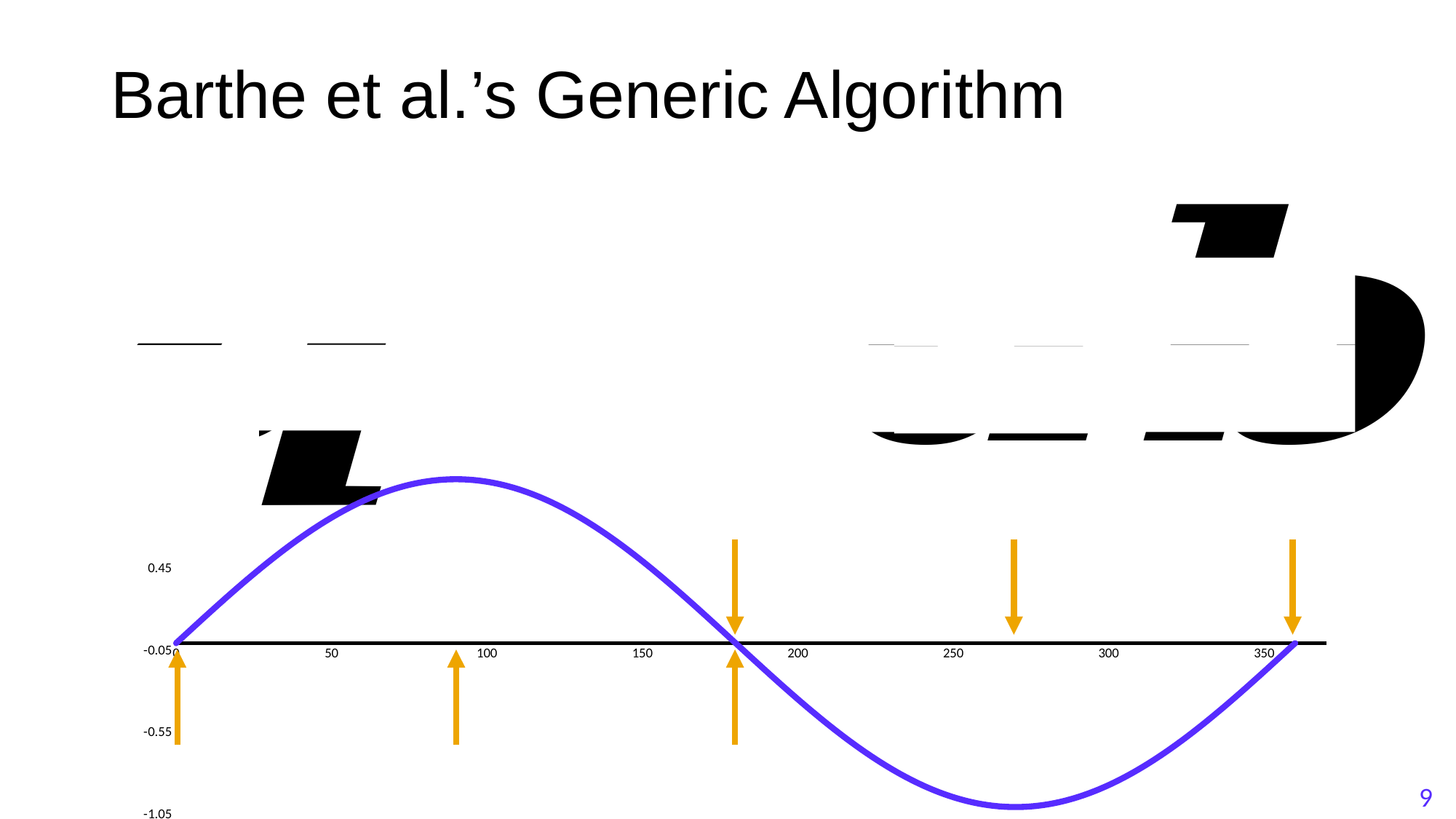
Which is larger, the value of the curve at x = 300 or at x = 100? x = 100 How many labelled tick marks are on the x axis? 7 Which is larger, the value of the curve at x = 50 or at x = 250? x = 50 Does the curve rise or fall as x goes from 100 to 250? fall Is the value of the curve at x = 100 greater or less than 0.45? greater Is the value of the curve at x = 50 greater or less than 0.45? greater Is the value of the curve at x = 200 greater or less than -0.05? less Does the curve rise or fall as x goes from 0 to 100? rise What colour is the plotted curve? purple What kind of chart is shown on the slide? line chart